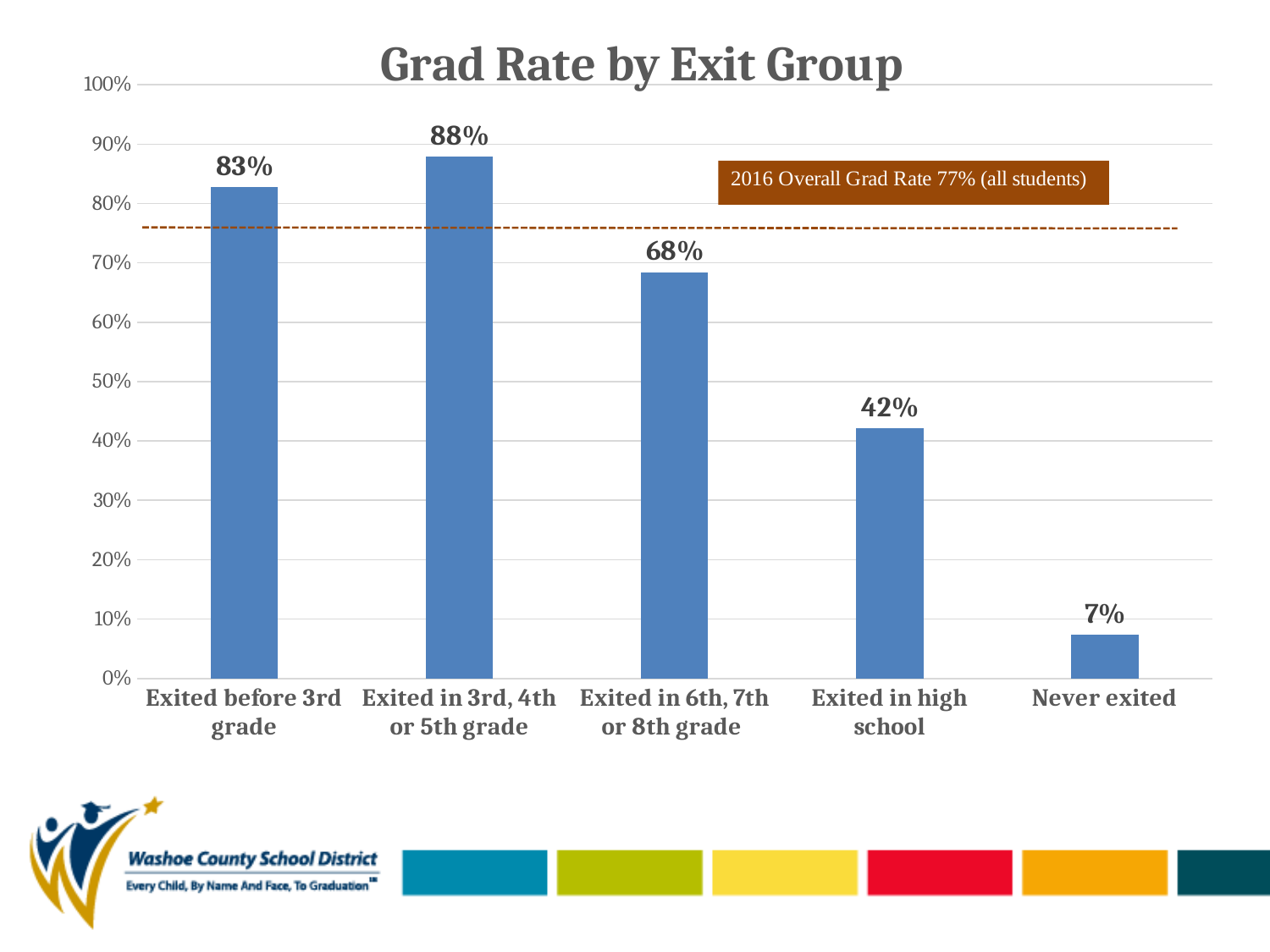
Do the grad rates rise or fall moving from left to right after the second bar? Fall What is the grad rate for students who exited in high school? 42% What is the grad rate for students who never exited? 7% Which has a higher grad rate: students who exited before 3rd grade or students who exited in 6th, 7th or 8th grade? Exited before 3rd grade What is the difference in grad rate between students who exited in 6th, 7th or 8th grade and those who exited in high school? 26% What overall grad rate does the dashed reference line on the chart represent? 77% What kind of chart is shown on the slide? Bar chart How many exit groups are shown in the chart? 5 What is the grad rate for students who exited in 3rd, 4th or 5th grade? 88% Which exit group has the lowest grad rate? Never exited What is the grad rate for students who exited before 3rd grade? 83% Which exit group has the highest grad rate? Exited in 3rd, 4th or 5th grade